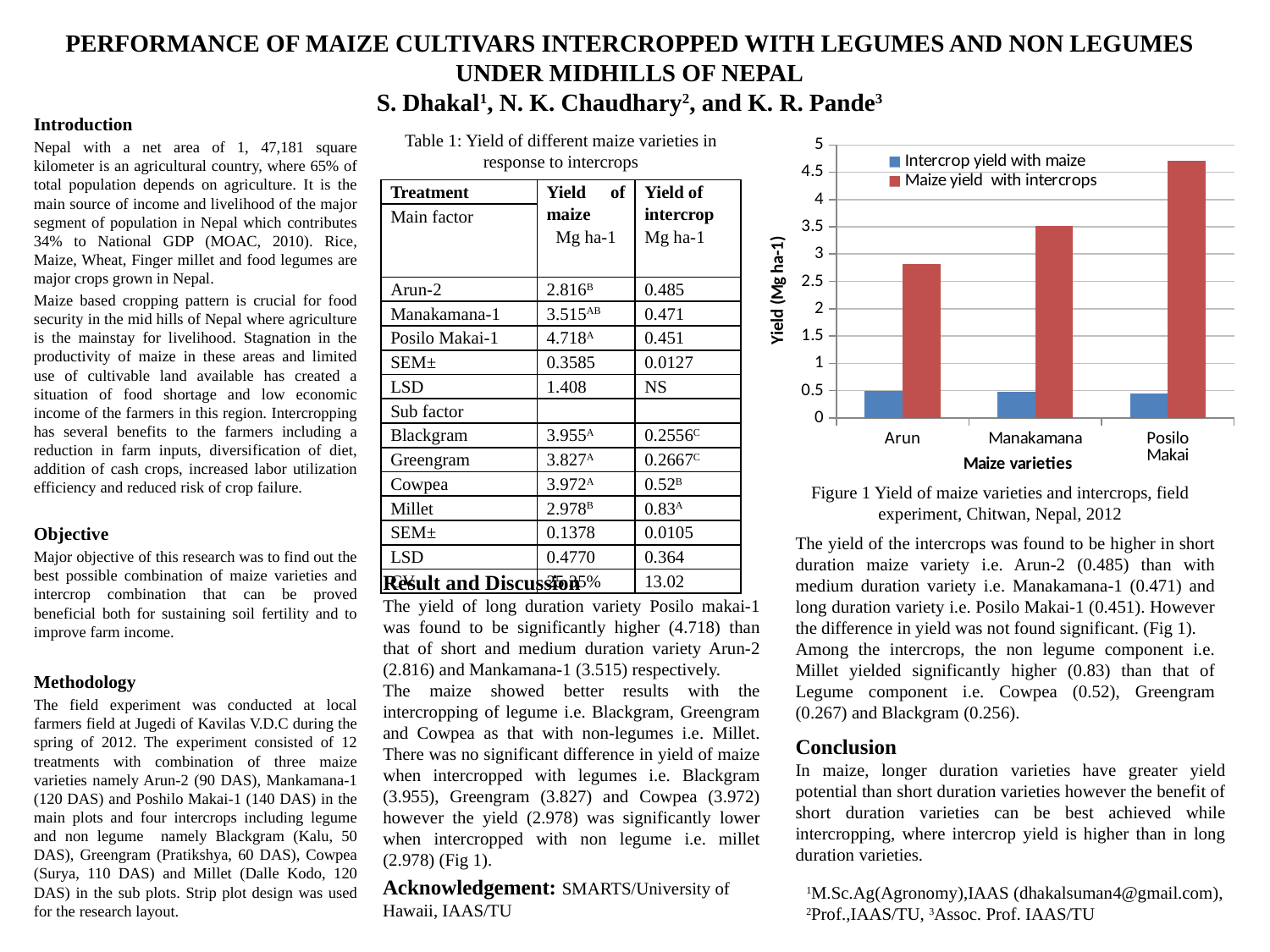
In Figure 1, is the intercrop yield with maize for Arun greater or less than 1? less In Figure 1, is the maize yield with intercrops for Posilo Makai greater or less than 4? greater In Figure 1, which is larger: the maize yield with intercrops for Manakamana or for Arun? Manakamana How many maize varieties are shown on the x axis of Figure 1? 3 In Figure 1, is the maize yield with intercrops for Manakamana greater or less than 3? greater Which maize variety has the lowest maize yield with intercrops in Figure 1? Arun What is the y-axis title of Figure 1? Yield (Mg ha-1) Which maize variety has the highest maize yield with intercrops in Figure 1? Posilo Makai What kind of chart is Figure 1? bar chart How many series does the legend of Figure 1 list? 2 In Figure 1, does the maize yield with intercrops rise or fall from Arun to Posilo Makai? rise